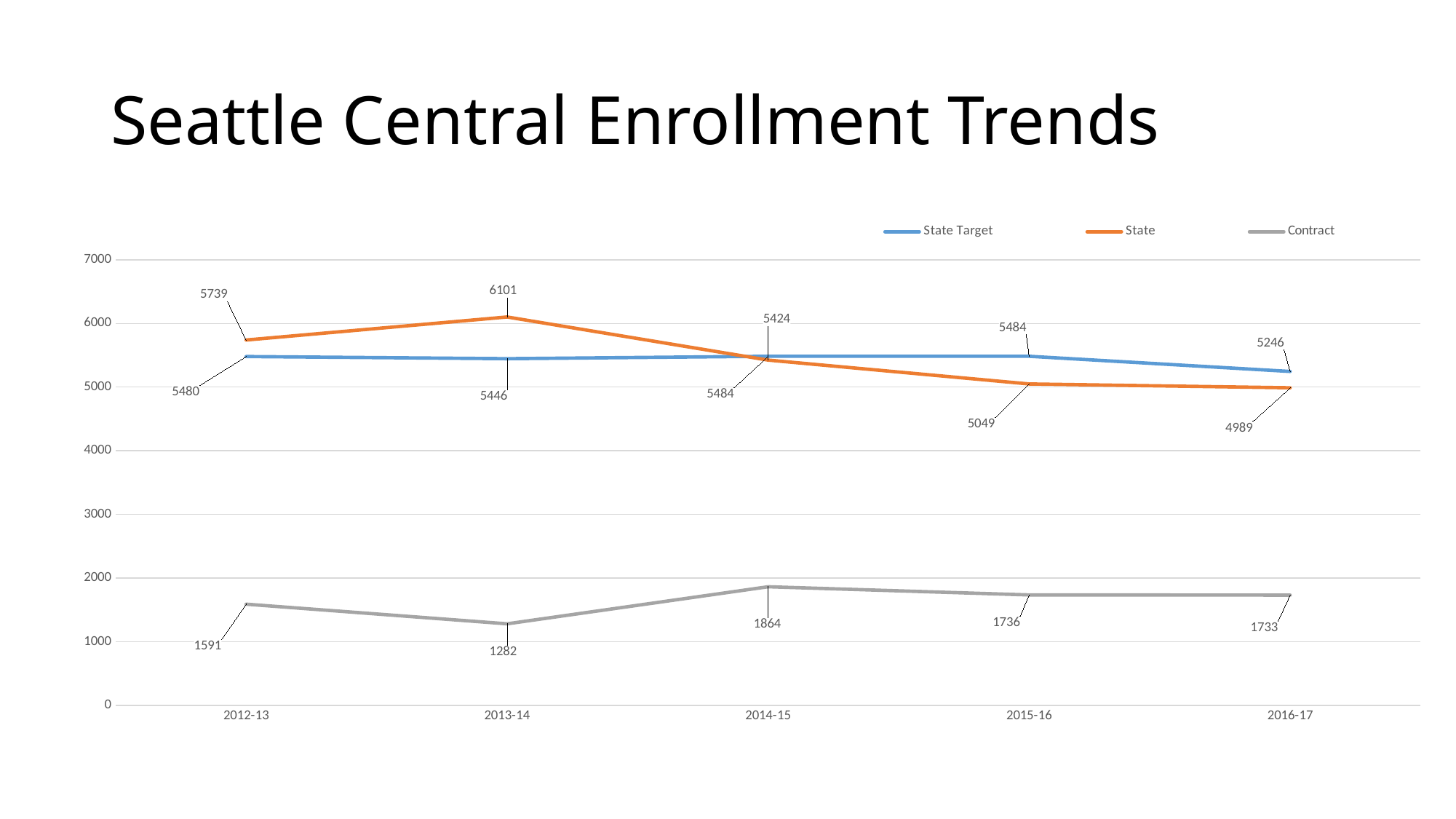
In which year is the Contract series lowest? 2013-14 How many series does the legend list? 3 What is the title of the chart? Seattle Central Enrollment Trends How many academic years are plotted on the x axis? 5 Which is larger in 2016-17, State Target or State? State Target Does the State series rise or fall from 2013-14 to 2016-17? fall What type of chart is shown on the slide? line chart What is the State Target value for 2016-17? 5246 In which year is the State series highest? 2013-14 What is the difference between the State value and the State Target value in 2012-13? 259 What is the Contract value for 2014-15? 1864 What is the State value for 2013-14? 6101